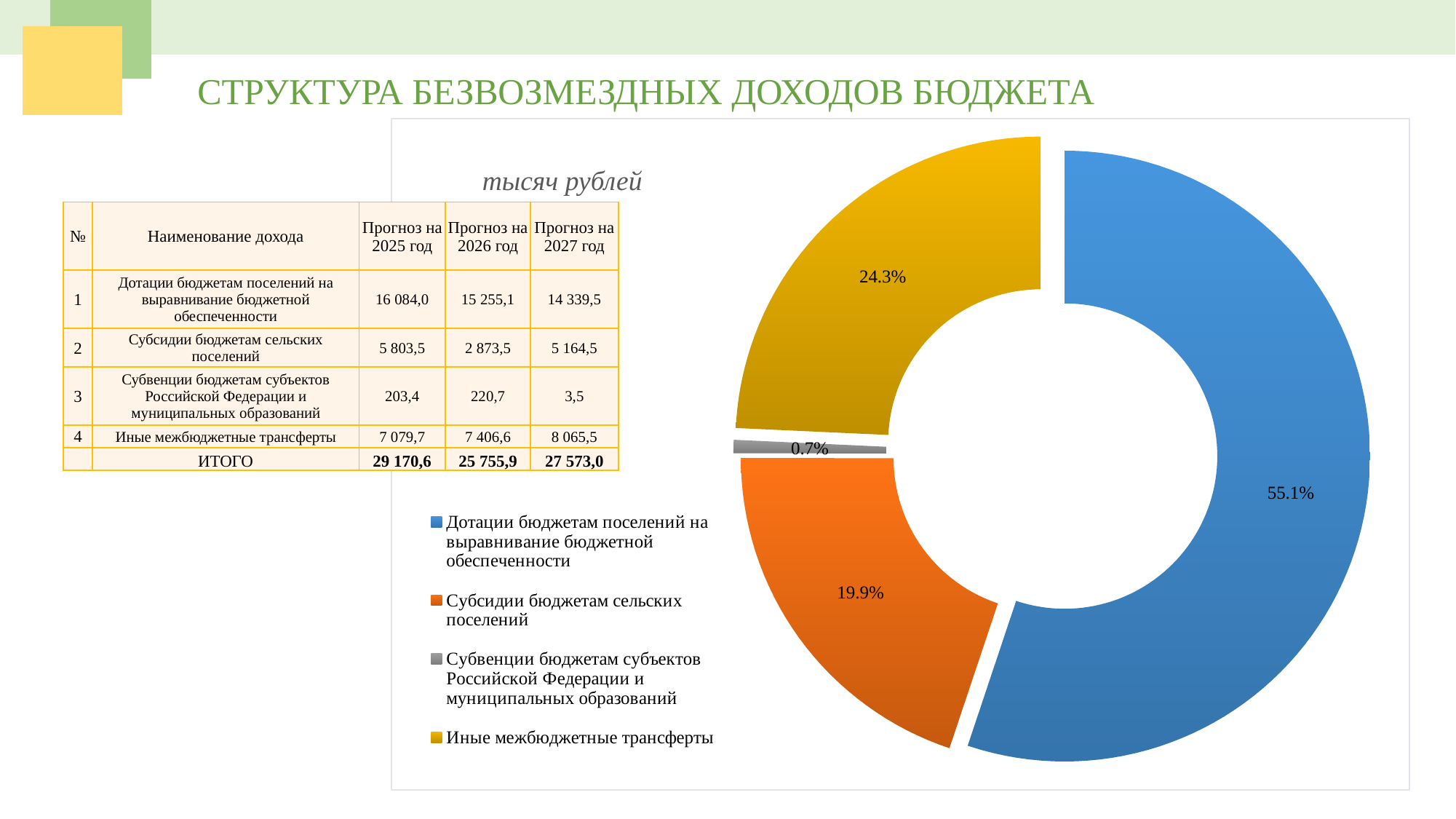
What share of the doughnut chart does the slice for Иные межбюджетные трансферты represent? 24.3% What is the difference in percentage points between the slice for Дотации бюджетам поселений на выравнивание бюджетной обеспеченности and the slice for Иные межбюджетные трансферты? 30.8 percentage points Which category has the largest slice in the doughnut chart? Дотации бюджетам поселений на выравнивание бюджетной обеспеченности What kind of chart is shown on the slide? Doughnut (pie) chart What is the title shown above the doughnut chart? тысяч рублей What share of the doughnut chart does the slice for Субсидии бюджетам сельских поселений represent? 19.9% What share of the doughnut chart does the slice for Субвенции бюджетам субъектов Российской Федерации и муниципальных образований represent? 0.7% Which category has the smallest slice in the doughnut chart? Субвенции бюджетам субъектов Российской Федерации и муниципальных образований Which slice is larger in the doughnut chart: Субсидии бюджетам сельских поселений or Иные межбюджетные трансферты? Иные межбюджетные трансферты What is the difference in percentage points between the slice for Иные межбюджетные трансферты and the slice for Субсидии бюджетам сельских поселений? 4.4 percentage points How many slices does the doughnut chart have? 4